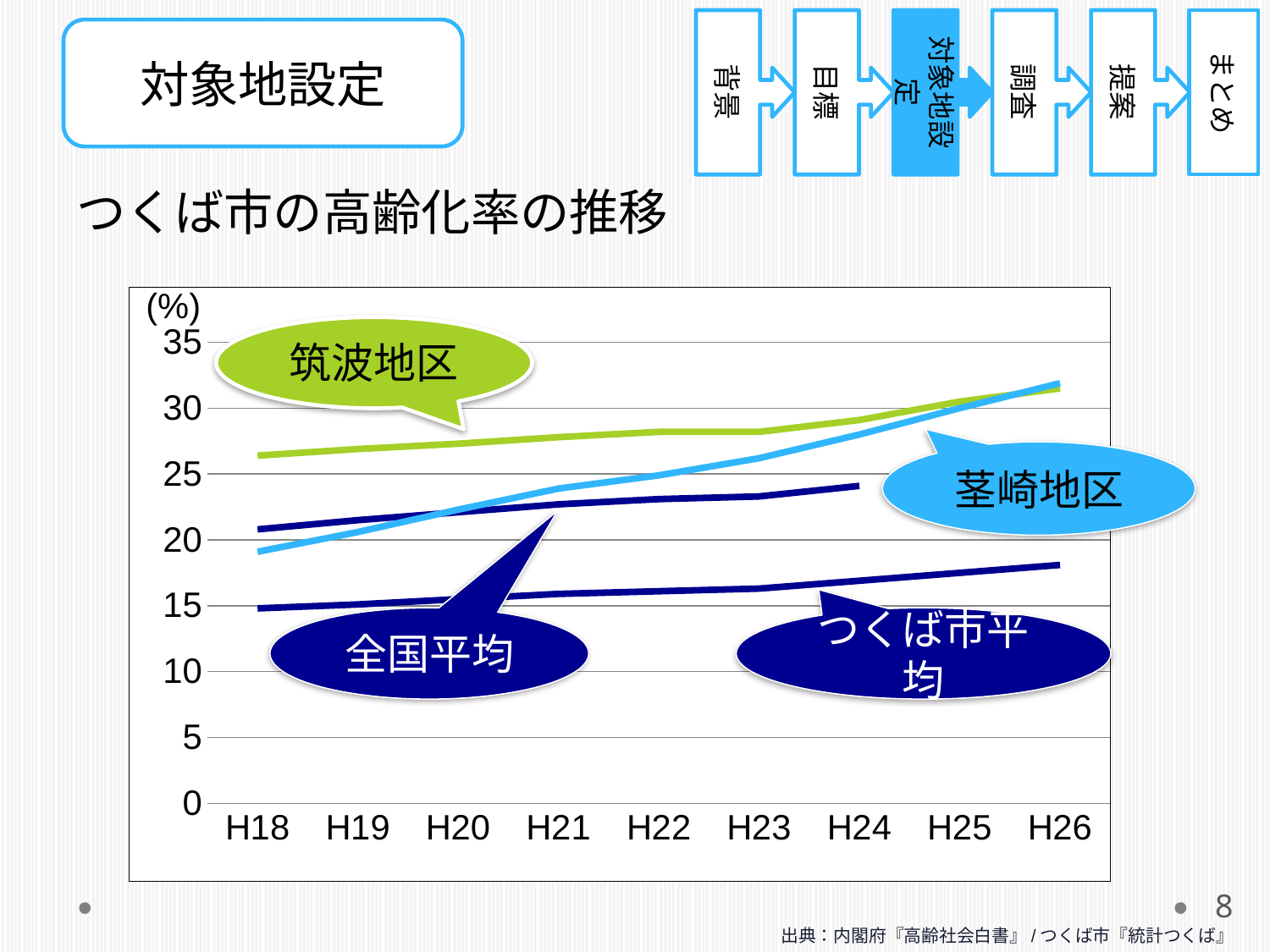
Is the value for 茎崎地区 in H18 greater or less than 20? less What unit is shown on the y axis of the chart? % Is the value for 茎崎地区 in H26 greater or less than 30? greater Which series has the highest value in H18? 筑波地区 Is the value for つくば市平均 in H26 greater or less than 15? greater How many years are shown on the x axis of the chart? 9 How many series (lines) are labelled on the chart? 4 What is the title of the chart? つくば市の高齢化率の推移 What kind of chart is shown on the slide? line chart Which series has the lowest values across all years shown? つくば市平均 Does the value for 茎崎地区 rise or fall from H18 to H26? rise